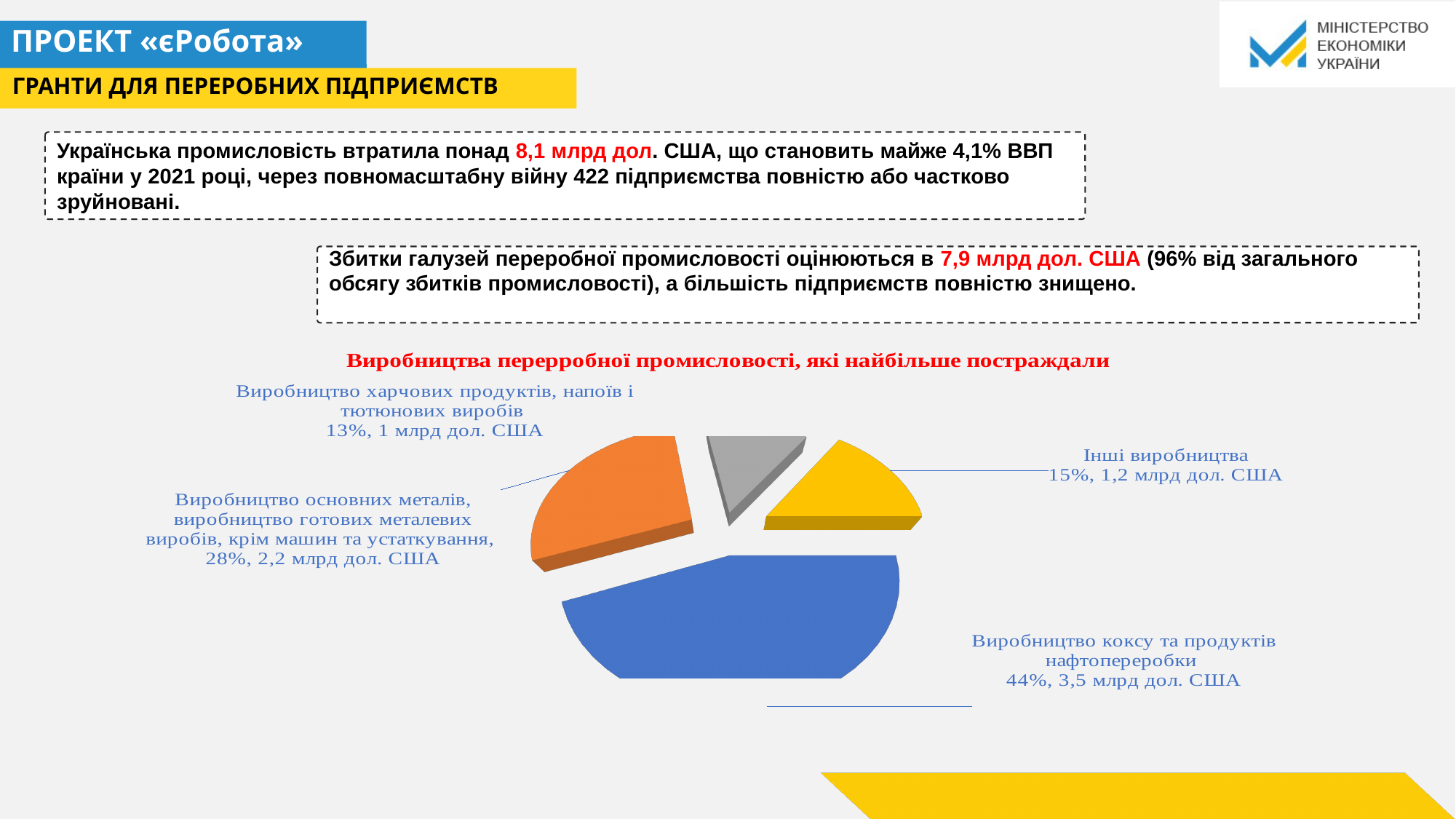
How many slices does the pie chart have? 4 What is the value in млрд дол. США for "Інші виробництва"? 1,2 млрд дол. США What is the value in млрд дол. США for "Виробництво коксу та продуктів нафтопереробки"? 3,5 млрд дол. США What kind of chart is shown on the slide? pie chart What is the difference in percentage points between the share for "Виробництво коксу та продуктів нафтопереробки" and the share for "Виробництво основних металів, виробництво готових металевих виробів, крім машин та устаткування"? 16% What share of the pie does "Виробництво основних металів, виробництво готових металевих виробів, крім машин та устаткування" represent? 28% What is the title of the pie chart? Виробництва перерробної промисловості, які найбільше постраждали Which category has the largest slice of the pie? Виробництво коксу та продуктів нафтопереробки What share of the pie does "Виробництво харчових продуктів, напоїв і тютюнових виробів" represent? 13% Which is larger: the share for "Інші виробництва" or the share for "Виробництво харчових продуктів, напоїв і тютюнових виробів"? Інші виробництва What share of the pie does "Виробництво коксу та продуктів нафтопереробки" represent? 44% Which category has the smallest slice of the pie? Виробництво харчових продуктів, напоїв і тютюнових виробів